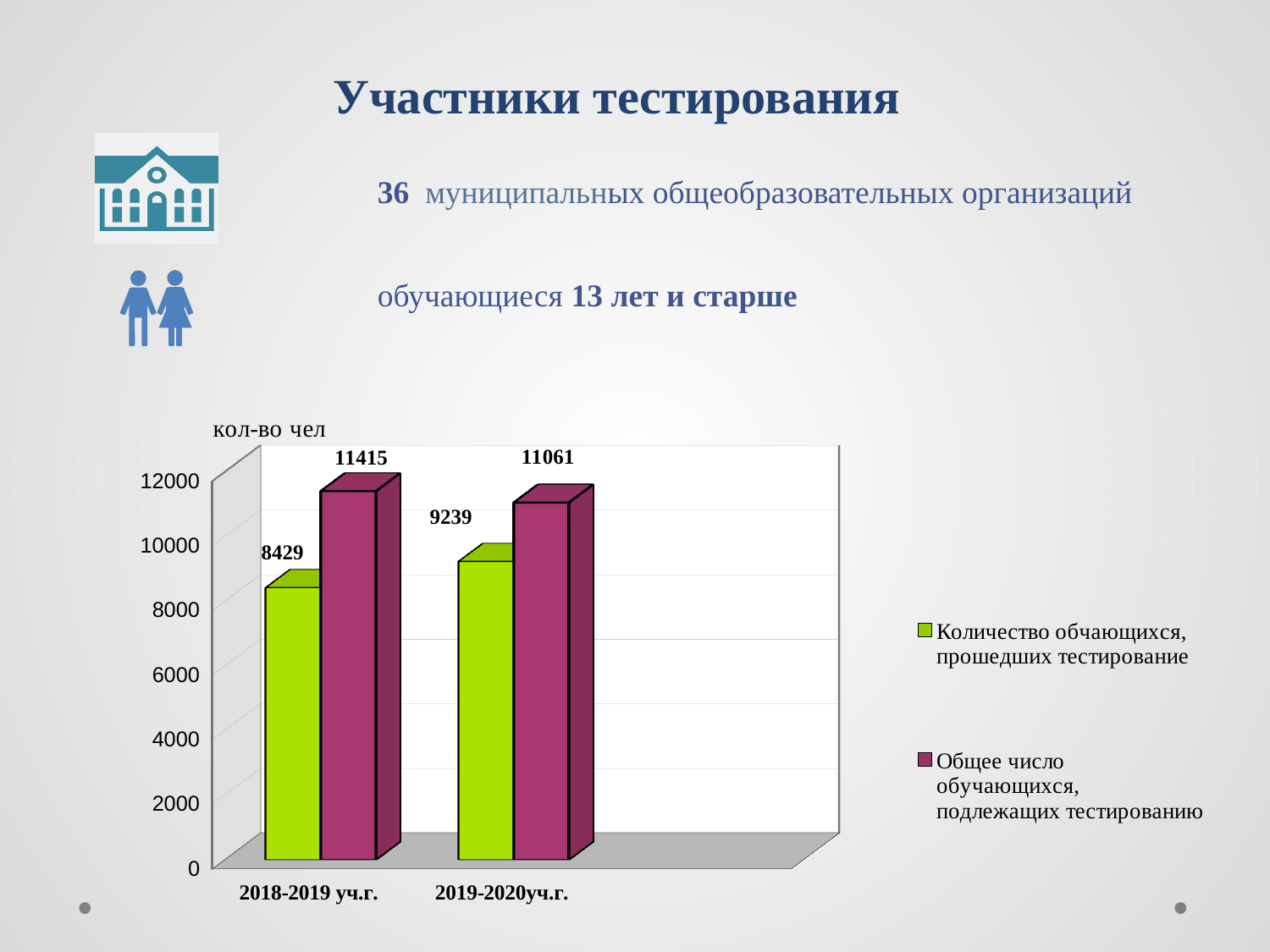
What is the value for "Общее число обучающихся, подлежащих тестированию" in 2019-2020уч.г.? 11061 How many series does the legend list? 2 What is the value for "Количество обчающихся, прошедших тестирование" in 2018-2019 уч.г.? 8429 What is the difference between "Общее число обучающихся, подлежащих тестированию" and "Количество обчающихся, прошедших тестирование" in 2018-2019 уч.г.? 2986 Does "Количество обчающихся, прошедших тестирование" rise or fall from 2018-2019 уч.г. to 2019-2020уч.г.? rise Which year has the lower value for "Количество обчающихся, прошедших тестирование"? 2018-2019 уч.г. Which year has the higher value for "Общее число обучающихся, подлежащих тестированию"? 2018-2019 уч.г. What is the value for "Количество обчающихся, прошедших тестирование" in 2019-2020уч.г.? 9239 By how much did "Количество обчающихся, прошедших тестирование" change from 2018-2019 уч.г. to 2019-2020уч.г.? 810 What kind of chart is shown on the slide? bar chart What is the value for "Общее число обучающихся, подлежащих тестированию" in 2018-2019 уч.г.? 11415 Is the value for "Количество обчающихся, прошедших тестирование" in 2019-2020уч.г. greater or less than 10000? less